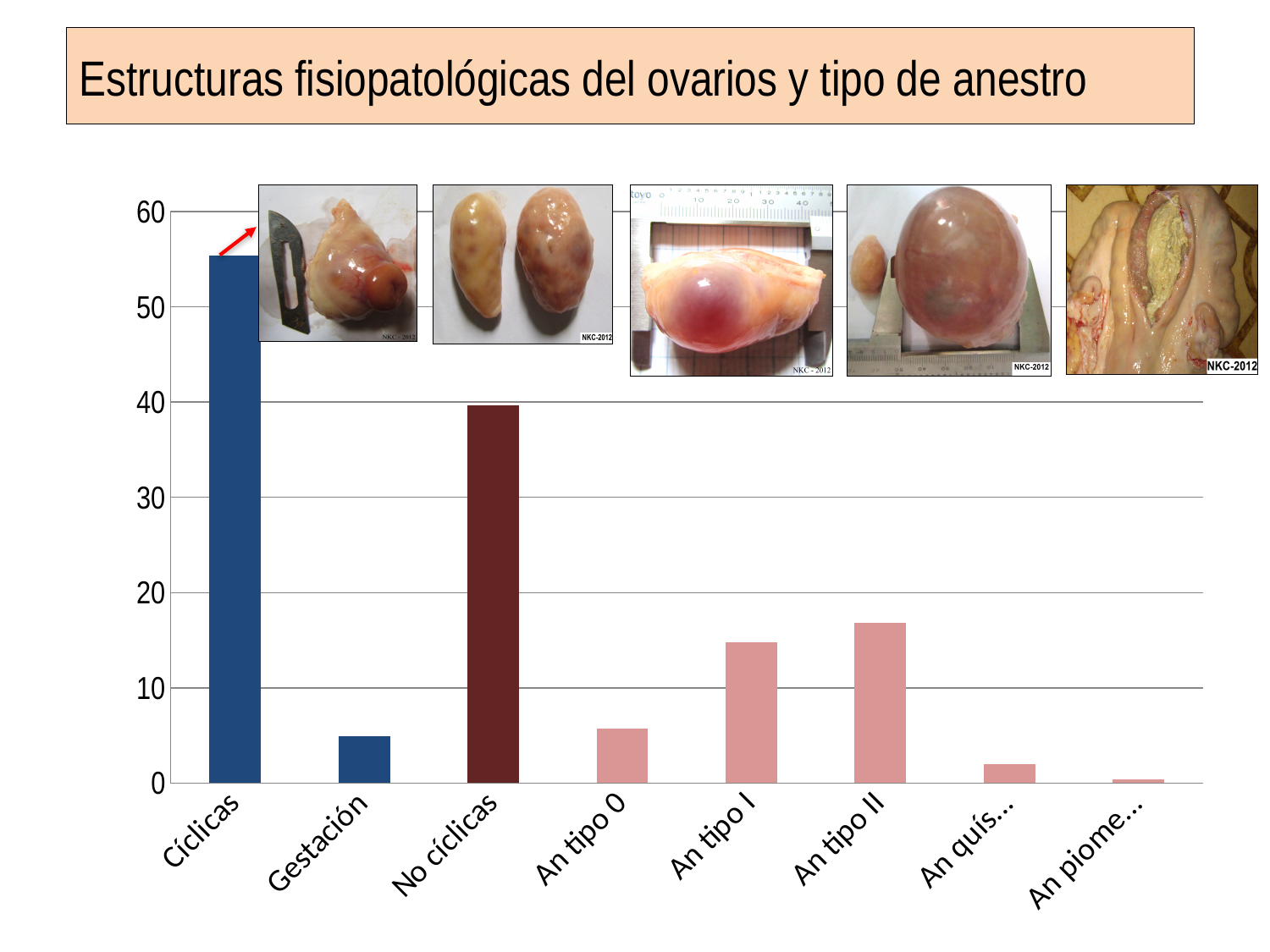
Is the value for An tipo II greater or less than 20? less Which is larger, the value for Cíclicas or the value for No cíclicas? Cíclicas How many categories are plotted on the x axis of the chart? 8 Which category has the highest bar in the chart? Cíclicas Which is larger, the value for Gestación or the value for An tipo II? An tipo II What is the title shown at the top of the slide? Estructuras fisiopatológicas del ovarios y tipo de anestro Which is larger, the value for An tipo 0 or the value for An tipo I? An tipo I What kind of chart is shown on the slide? bar chart Is the value for An tipo I greater or less than 10? greater Is the value for Gestación greater or less than 10? less